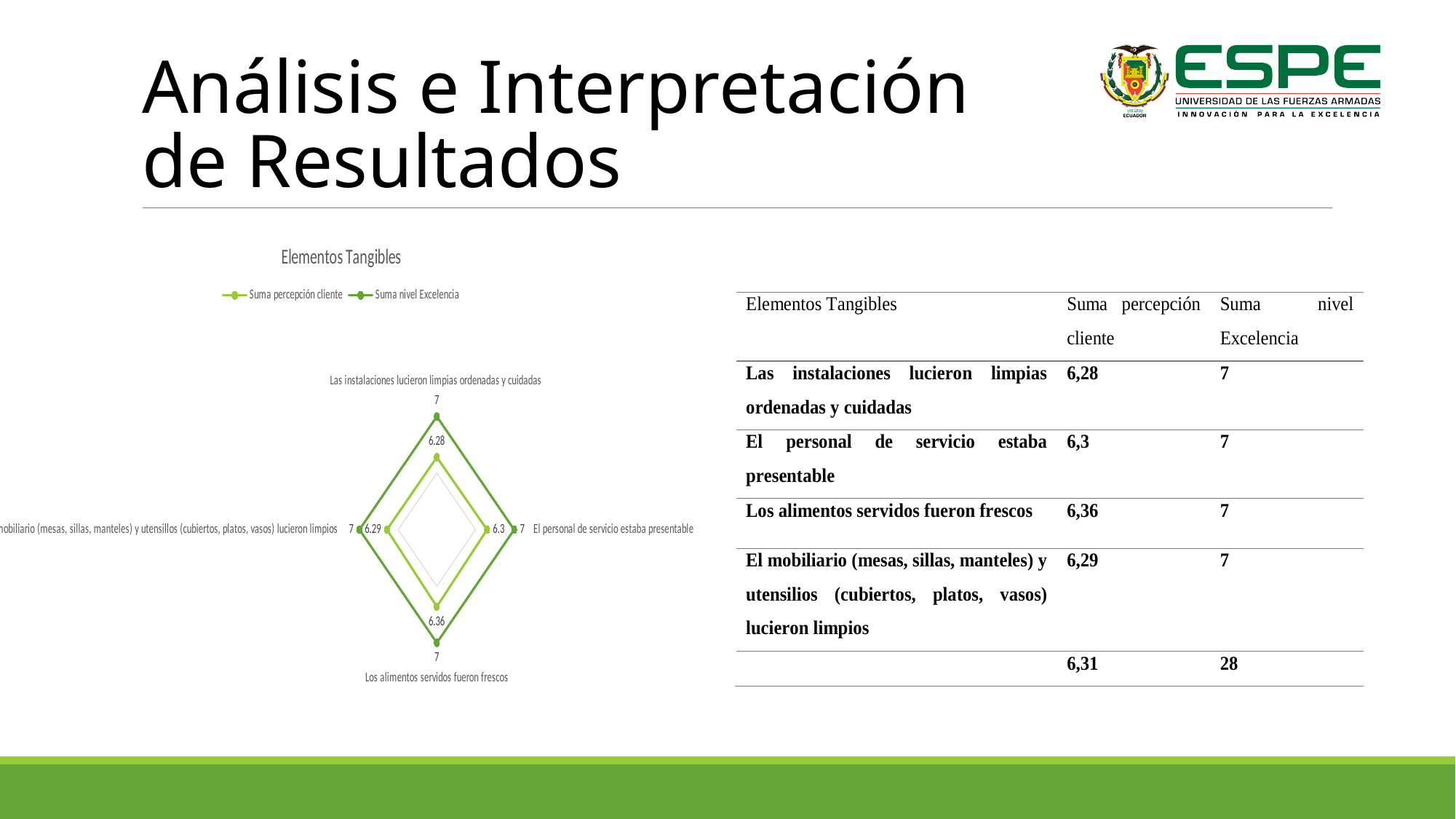
What is the title of the chart on the slide? Elementos Tangibles How many categories are plotted on the radar chart? 4 What is the value of Suma percepción cliente for 'El personal de servicio estaba presentable'? 6.3 What is the value of Suma percepción cliente for 'Los alimentos servidos fueron frescos'? 6.36 What kind of chart is shown on the slide? Radar chart Which category has the highest Suma percepción cliente value? Los alimentos servidos fueron frescos Which category has the lowest Suma percepción cliente value? Las instalaciones lucieron limpias ordenadas y cuidadas What is the value of Suma percepción cliente for 'Las instalaciones lucieron limpias ordenadas y cuidadas'? 6.28 What is the difference between Suma nivel Excelencia and Suma percepción cliente for 'Los alimentos servidos fueron frescos'? 0.64 How many series does the chart legend list? 2 What is the value of Suma nivel Excelencia for 'El personal de servicio estaba presentable'? 7 Which series has the larger value for 'Las instalaciones lucieron limpias ordenadas y cuidadas', Suma percepción cliente or Suma nivel Excelencia? Suma nivel Excelencia